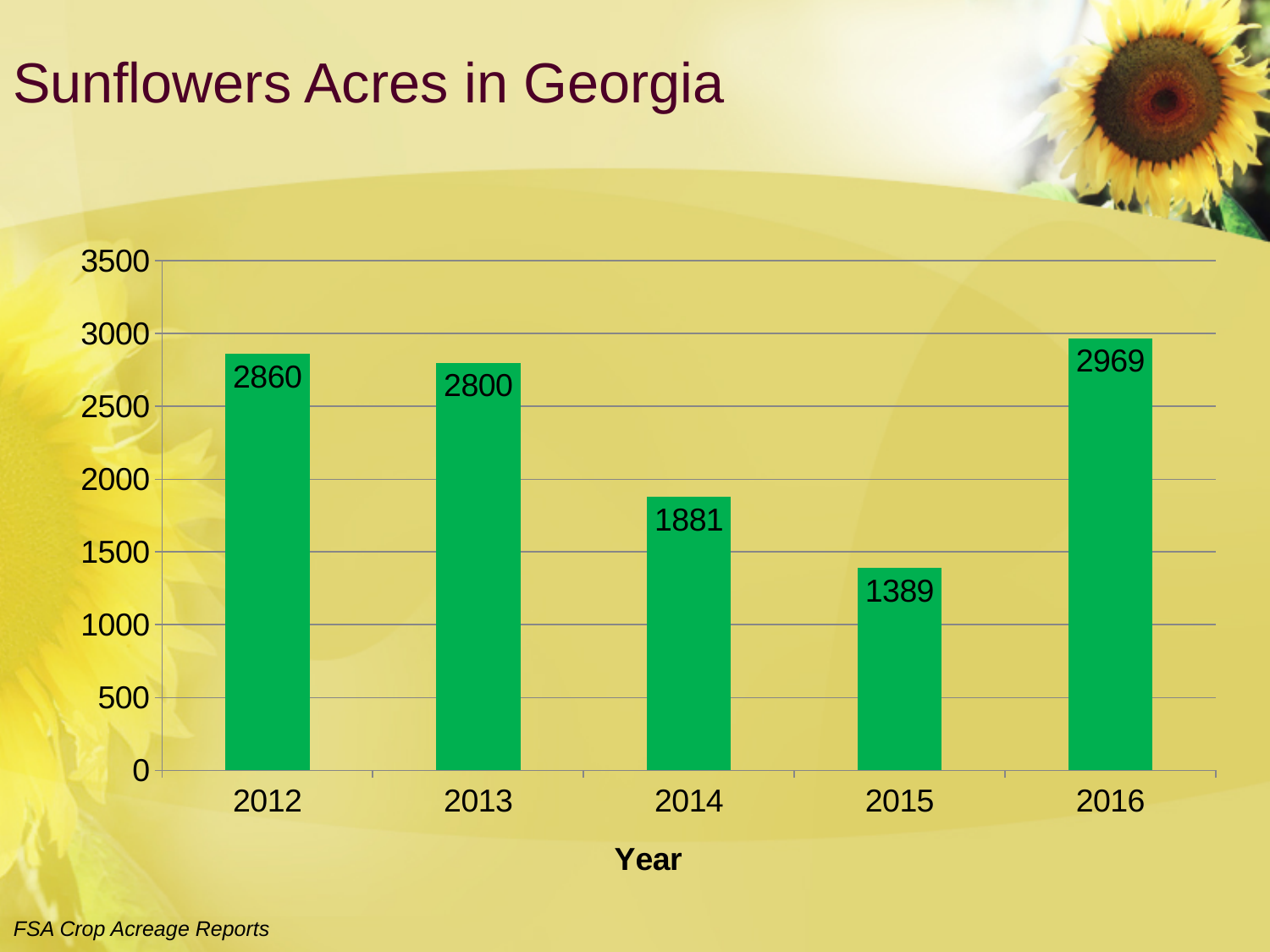
Which is larger, the value for 2013 or the value for 2014? 2013 Which year has the highest value? 2016 Is the value for 2015 greater or less than 1500? less What is the difference between the values for 2016 and 2015? 1580 How many years are shown on the x axis? 5 What is the value for 2012? 2860 Which year has the lowest value? 2015 What is the difference between the values for 2012 and 2013? 60 What is the value for 2014? 1881 What is the value for 2015? 1389 What kind of chart is shown on the slide? bar chart What is the title of the slide? Sunflowers Acres in Georgia